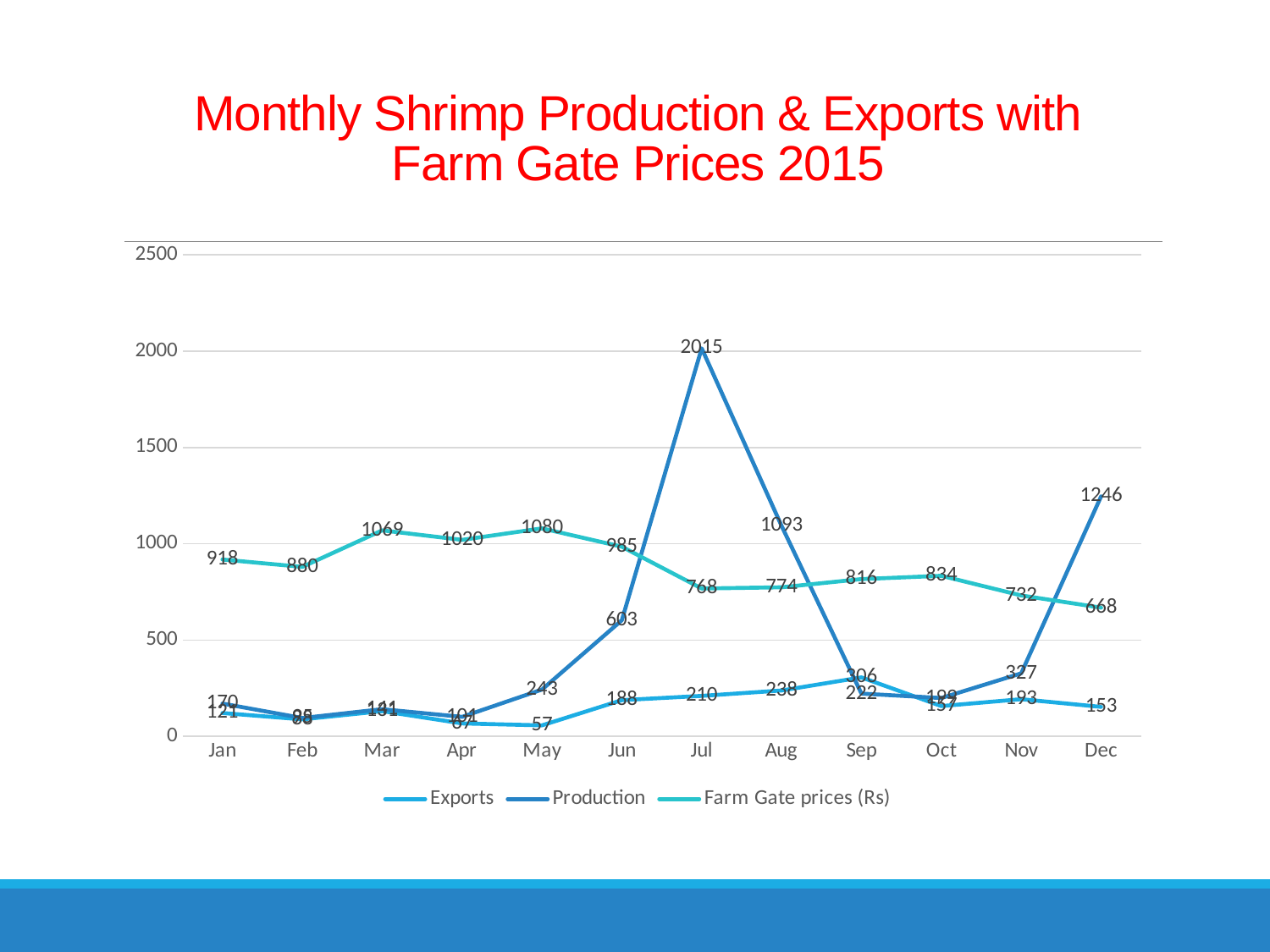
What is the difference between Production in Jul and Production in Aug? 922 How many series does the legend list? 3 Which is larger, Exports in Aug or Exports in Sep? Sep Is the Production value for Dec greater or less than 1000? greater What is the Farm Gate price for May? 1080 What is the Exports value for Dec? 153 In which month is the Farm Gate price lowest? Dec What is the difference between the Farm Gate price in Jan and in Feb? 38 In which month is Production highest? Jul What is the Production value for Jul? 2015 What kind of chart is shown on the slide? line chart How many months are shown on the x axis? 12